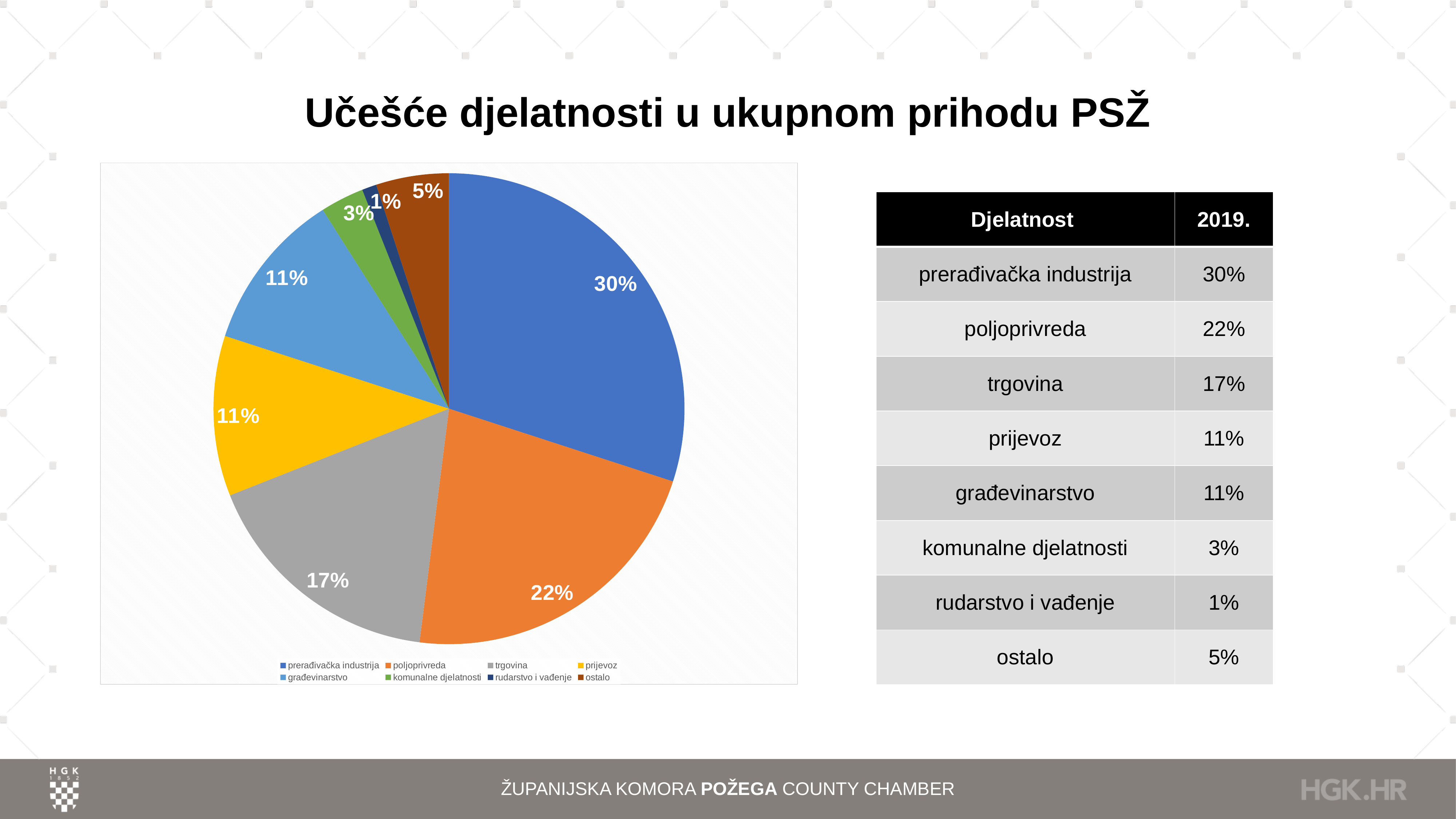
What type of chart is shown on the slide? pie chart What is the difference between the shares of prerađivačka industrija and poljoprivreda? 8% How many categories does the pie chart have? 8 Which category has the largest slice of the pie? prerađivačka industrija Which category has the smallest slice of the pie? rudarstvo i vađenje What is the value shown for komunalne djelatnosti? 3% What share of the pie does prerađivačka industrija have? 30% Which is larger, the share for trgovina or the share for ostalo? trgovina What is the title of the slide containing the chart? Učešće djelatnosti u ukupnom prihodu PSŽ What is the value shown for trgovina? 17% What is the value shown for rudarstvo i vađenje? 1% What is the value shown for poljoprivreda? 22%